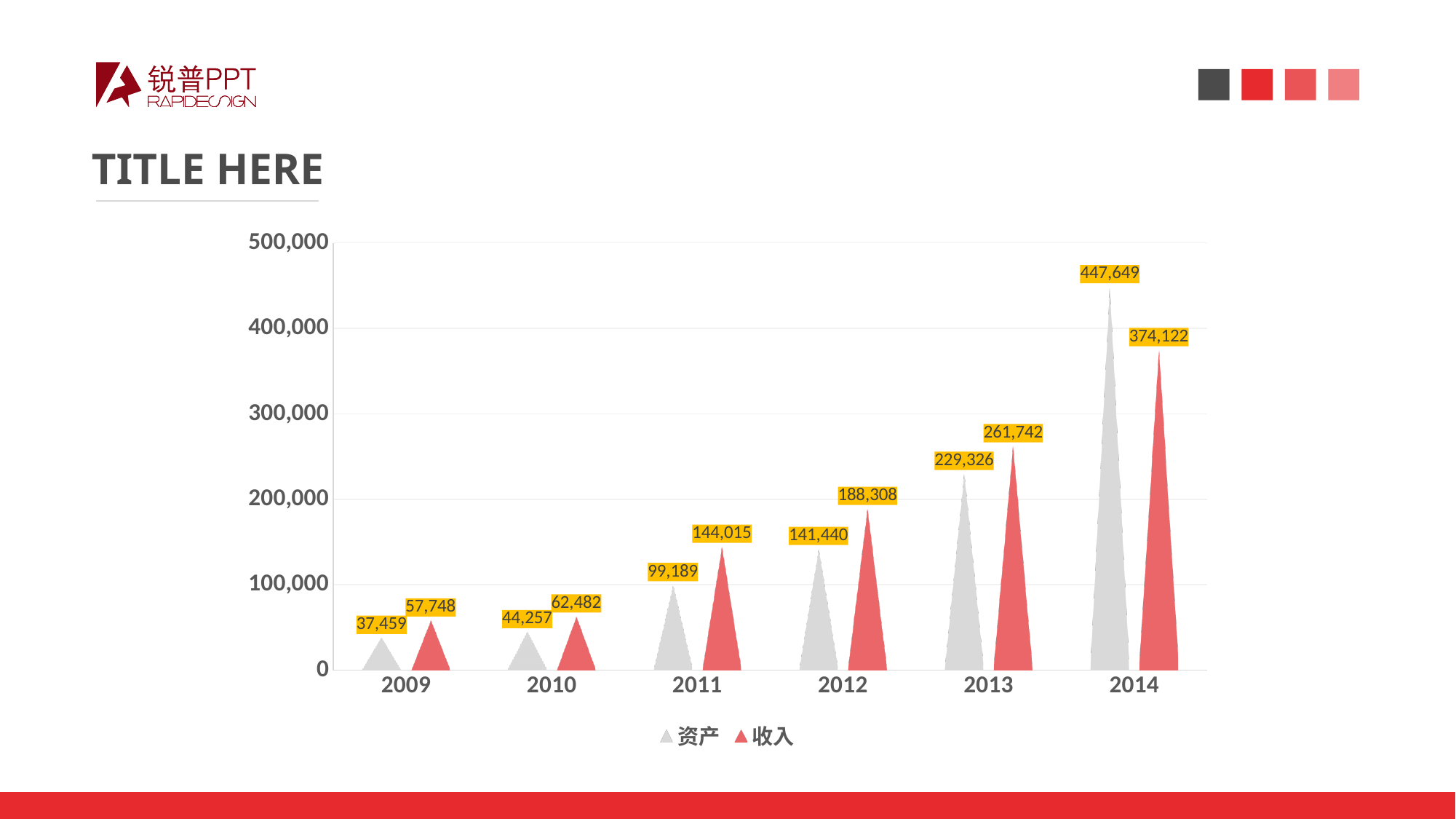
Does 资产 rise or fall from 2009 to 2014? rise Which is larger in 2013, 资产 or 收入? 收入 In which year is 收入 highest? 2014 What is the difference between 收入 and 资产 in 2009? 20,289 What is the value of 资产 in 2012? 141,440 What is the difference between 资产 and 收入 in 2014? 73,527 How many years are shown on the x axis? 6 What is the value of 收入 in 2009? 57,748 In which year is 资产 lowest? 2009 What is the value of 收入 in 2011? 144,015 How many series does the legend list? 2 What is the value of 资产 in 2014? 447,649